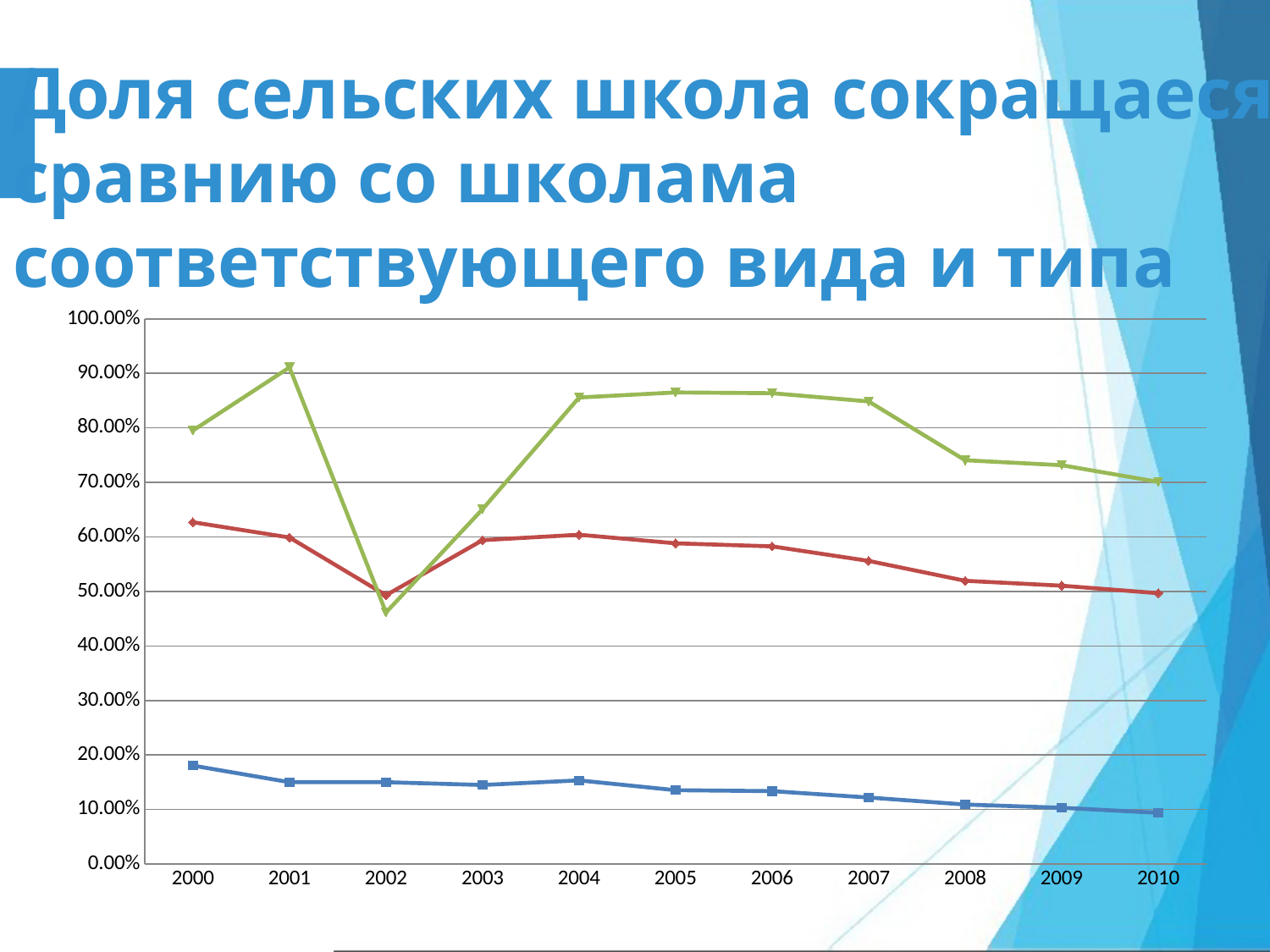
What kind of chart is shown on the slide? line chart How many lines (data series) are plotted on the chart? 3 In which year does the red line have its highest value? 2000 What is the highest value shown on the y axis of the chart? 100.00% In which year does the blue line have its highest value? 2000 In which year does the green line reach its lowest value? 2002 Is the value of the green line in 2002 greater or less than 50.00%? less Is the value of the blue line in 2000 greater or less than 10.00%? greater In which year does the green line reach its highest value? 2001 How many years are shown along the x axis of the chart? 11 Does the blue line rise or fall overall from 2000 to 2010? fall Is the value of the red line in 2000 greater or less than 60.00%? greater